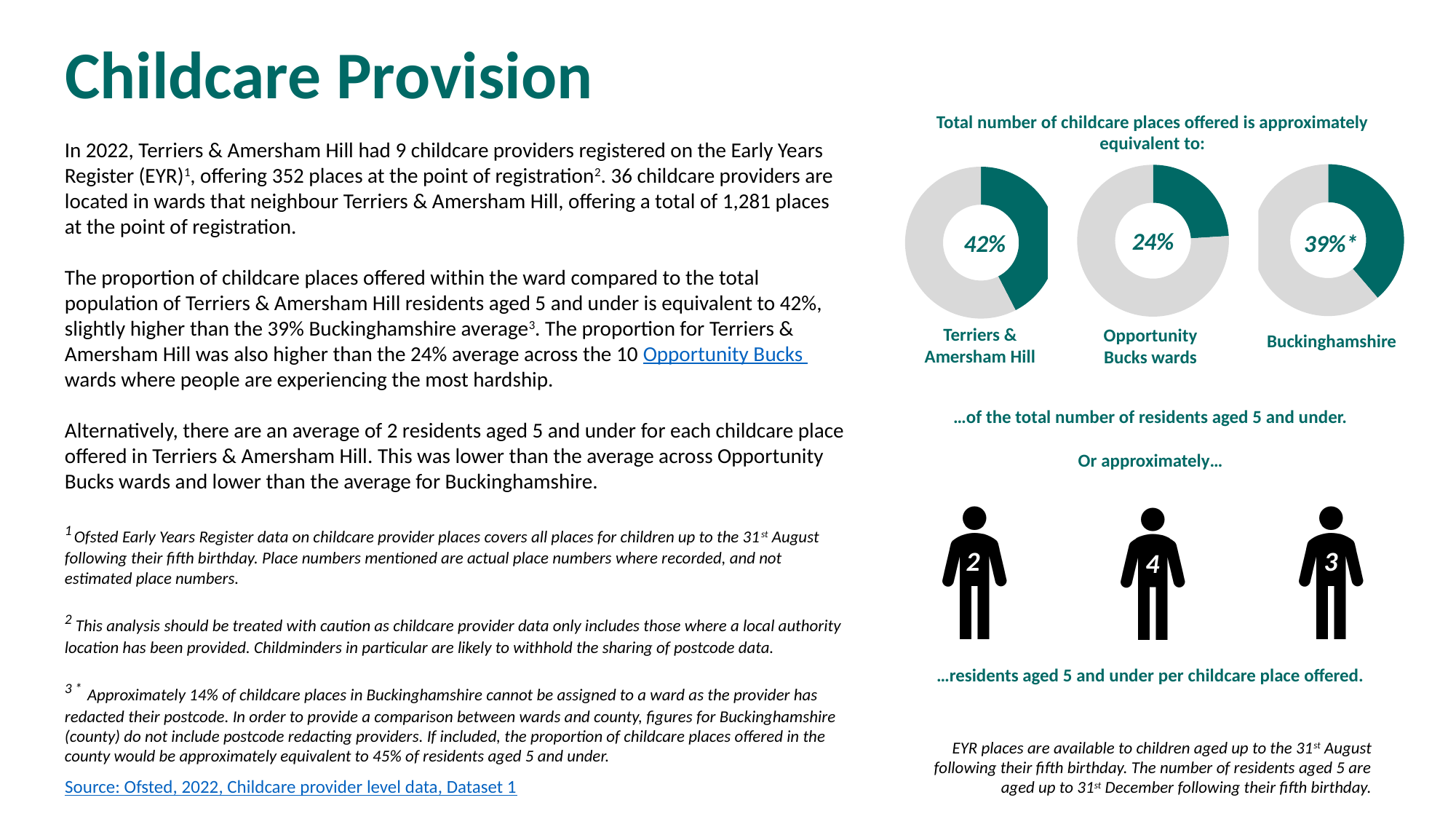
In the donut charts, what percentage is shown for Terriers & Amersham Hill? 42% Among the three donut charts, which area has the highest percentage? Terriers & Amersham Hill In the donut charts, what is the difference in percentage points between Terriers & Amersham Hill and Buckinghamshire? 3 percentage points How many donut charts are shown on the slide? 3 In the person icons, how many residents aged 5 and under per childcare place are shown for Opportunity Bucks wards? 4 In the donut charts, which has the larger percentage: Terriers & Amersham Hill or Buckinghamshire? Terriers & Amersham Hill What kind of chart is used to show the percentage of residents aged 5 and under on the slide? Donut (pie) chart In the donut charts, what percentage is shown for Opportunity Bucks wards? 24% In the donut charts, what is the difference in percentage points between Terriers & Amersham Hill and Opportunity Bucks wards? 18 percentage points In the person icons, how many residents aged 5 and under per childcare place are shown for Buckinghamshire? 3 In the donut charts, what percentage is shown for Buckinghamshire? 39% Among the three donut charts, which area has the lowest percentage? Opportunity Bucks wards